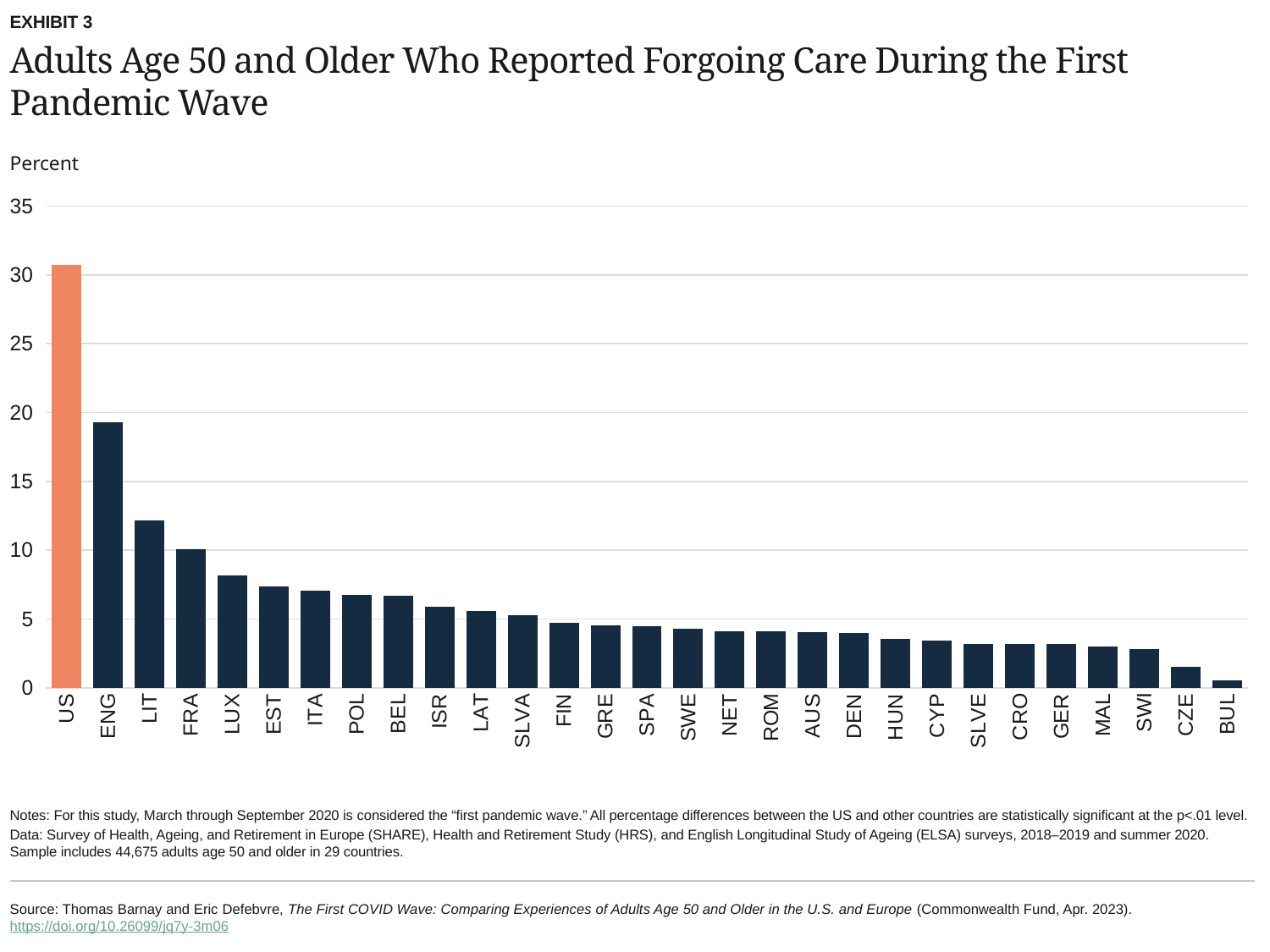
Do the values rise or fall moving from left to right across the countries? fall Which country's bar is shown in a different colour (orange) from the rest? US Is the value for LUX greater or less than 5? greater Is the value for BUL greater or less than 5? less Which has a higher value, ENG or LIT? ENG How many countries are shown on the chart? 29 Is the value for US greater or less than 25? greater Which country has the highest percentage of adults age 50 and older who reported forgoing care? US Which country has the lowest percentage of adults age 50 and older who reported forgoing care? BUL What kind of chart is shown on the slide? bar chart